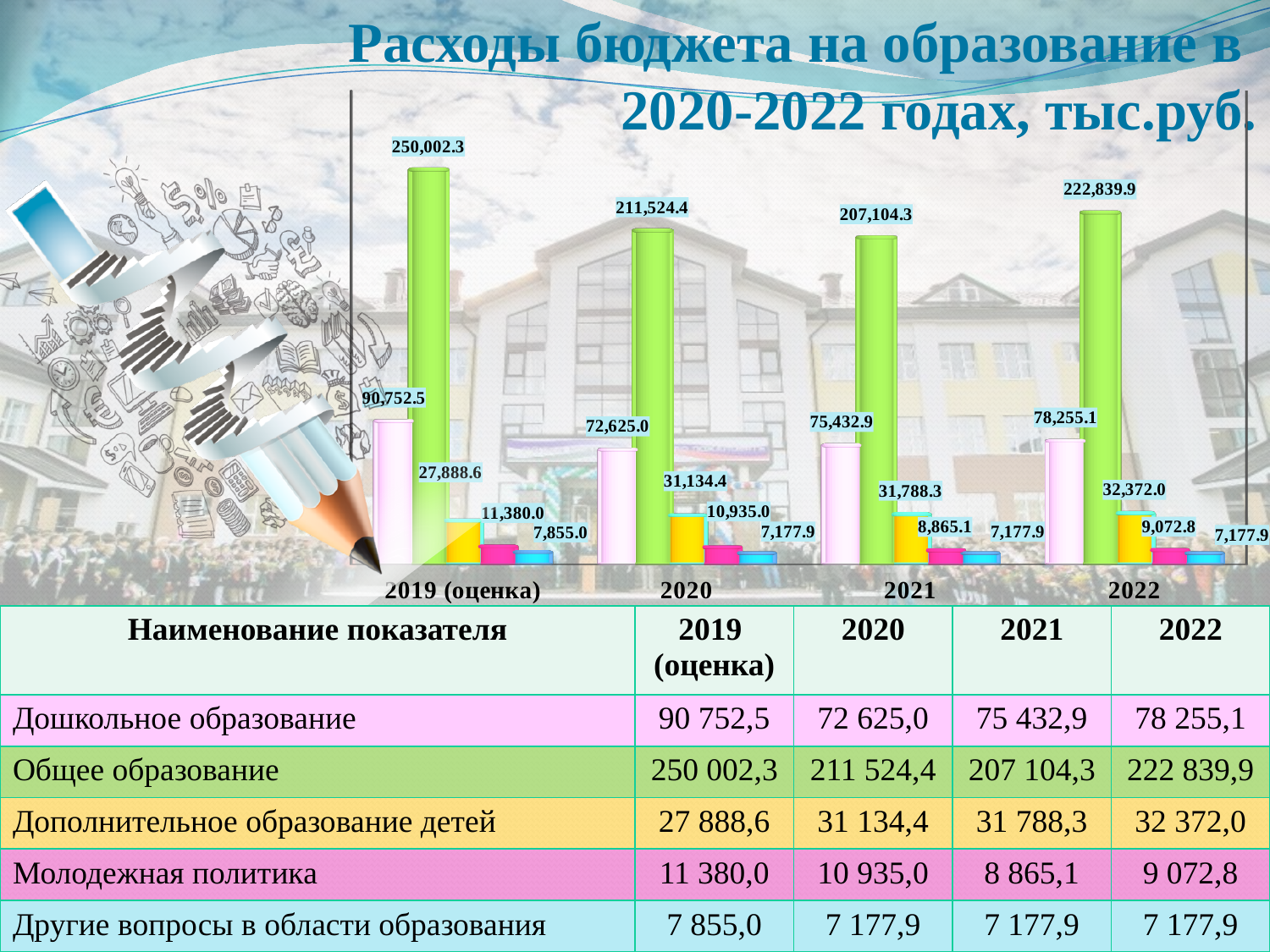
Which is larger: the pink bar for 2021 or the pink bar for 2022? 2022 What is the difference between the green bar values for 2019 (оценка) and 2020? 38,477.9 What is the value of the yellow bar (Дополнительное образование детей) for 2021? 31,788.3 In which year is the green bar (Общее образование) the lowest? 2021 What type of chart is shown on the slide? bar chart How many year categories are shown on the x axis of the chart? 4 What is the value of the tallest (green) bar for 2019 (оценка)? 250,002.3 Does the yellow bar (Дополнительное образование детей) rise or fall from 2019 (оценка) to 2022? rise What is the value of the pink bar (Дошкольное образование) for 2020? 72,625.0 What is the value of the green bar (Общее образование) for 2022? 222,839.9 What is the title of the chart? Расходы бюджета на образование в 2020-2022 годах, тыс.руб. In which year is the green bar (Общее образование) the highest? 2019 (оценка)